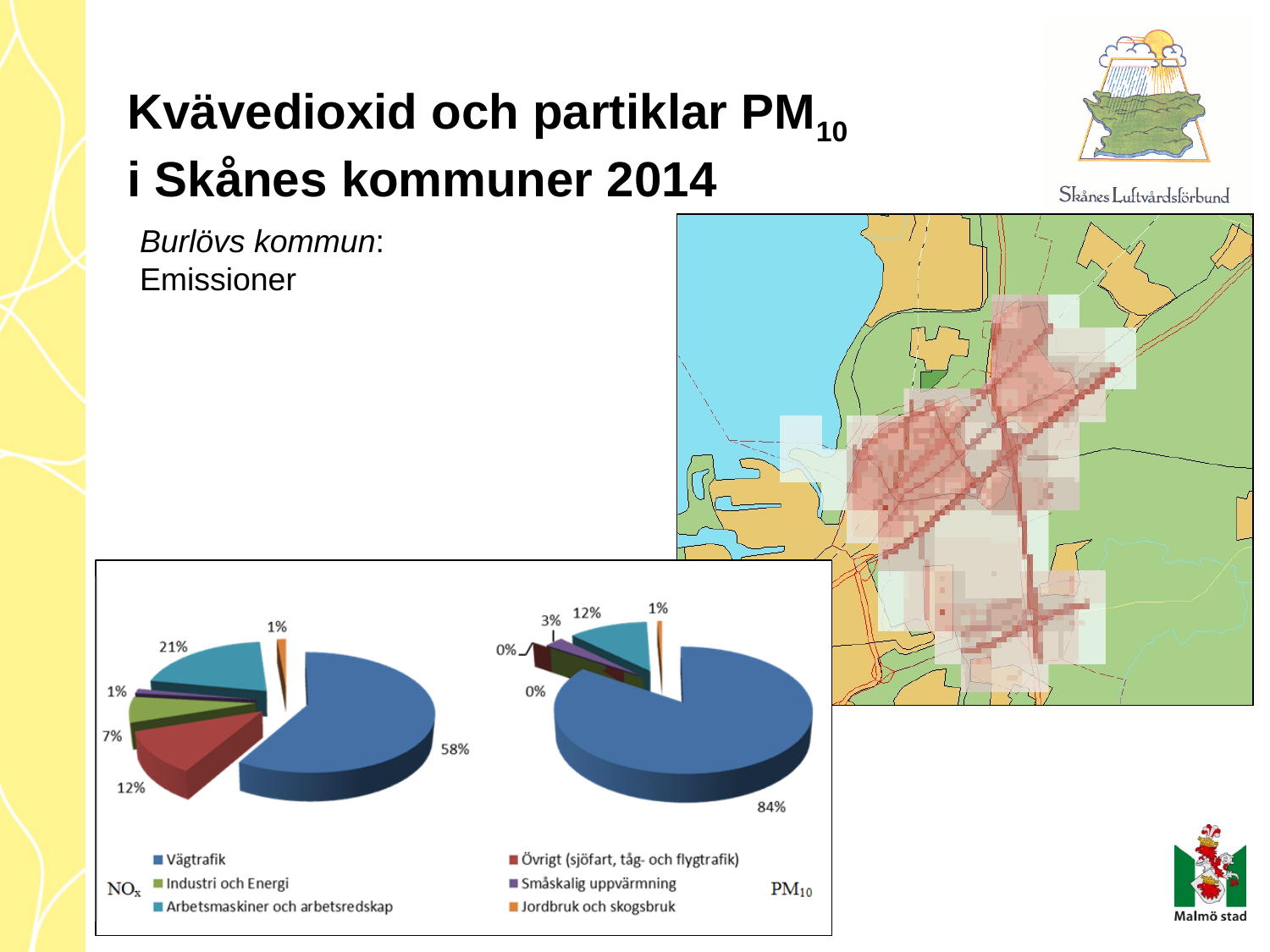
In the NOx pie chart, what share does Vägtrafik have? 58% In the PM10 pie chart, what share does Småskalig uppvärmning have? 3% In the PM10 pie chart, what share does Arbetsmaskiner och arbetsredskap have? 12% What kind of charts are shown at the bottom of the slide? Pie charts In the PM10 pie chart, what share does Vägtrafik have? 84% Is the share of Vägtrafik larger in the NOx pie chart or in the PM10 pie chart? PM10 In the NOx pie chart, what share does Industri och Energi have? 7% In the PM10 pie chart, which category has the largest share? Vägtrafik In the NOx pie chart, which category has the largest share? Vägtrafik What is the difference in percentage points between the Vägtrafik share in the PM10 chart (84%) and in the NOx chart (58%)? 26 percentage points How many categories does the shared legend of the pie charts list? 6 In the NOx pie chart, what share does Arbetsmaskiner och arbetsredskap have? 21%